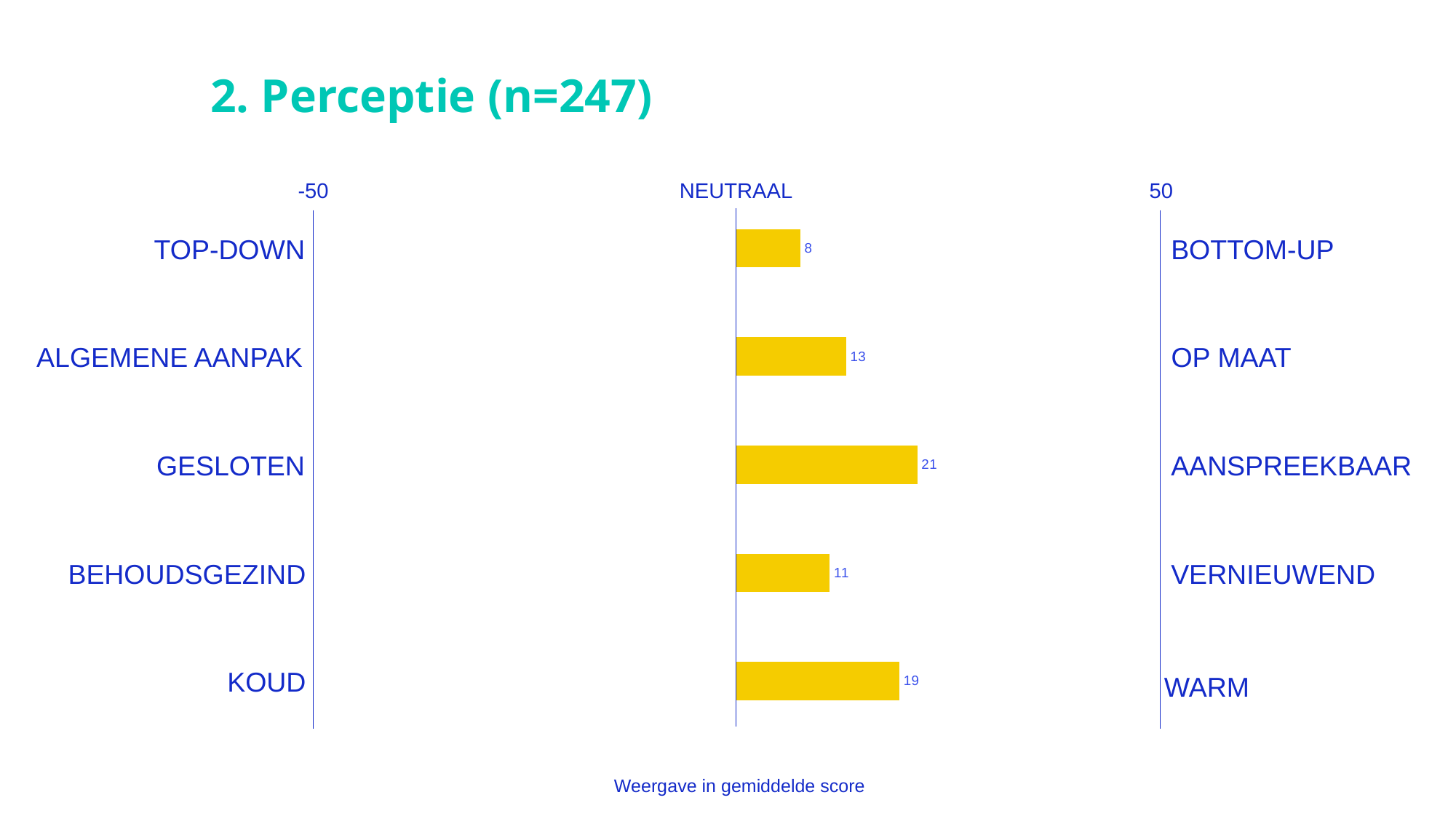
How many bars are plotted in the chart? 5 What is the value of the bar on the GESLOTEN / AANSPREEKBAAR row? 21 Which row has the lowest value? TOP-DOWN / BOTTOM-UP What is the value of the bar on the BEHOUDSGEZIND / VERNIEUWEND row? 11 What is the title of the slide? 2. Perceptie (n=247) What is the value of the bar on the ALGEMENE AANPAK / OP MAAT row? 13 What is the value of the bar on the TOP-DOWN / BOTTOM-UP row? 8 What is the difference between the GESLOTEN / AANSPREEKBAAR value and the KOUD / WARM value? 2 What is the value of the bar on the KOUD / WARM row? 19 What kind of chart is shown on the slide? Bar chart Which is larger, the value for ALGEMENE AANPAK / OP MAAT or the value for BEHOUDSGEZIND / VERNIEUWEND? ALGEMENE AANPAK / OP MAAT Which row has the highest value? GESLOTEN / AANSPREEKBAAR